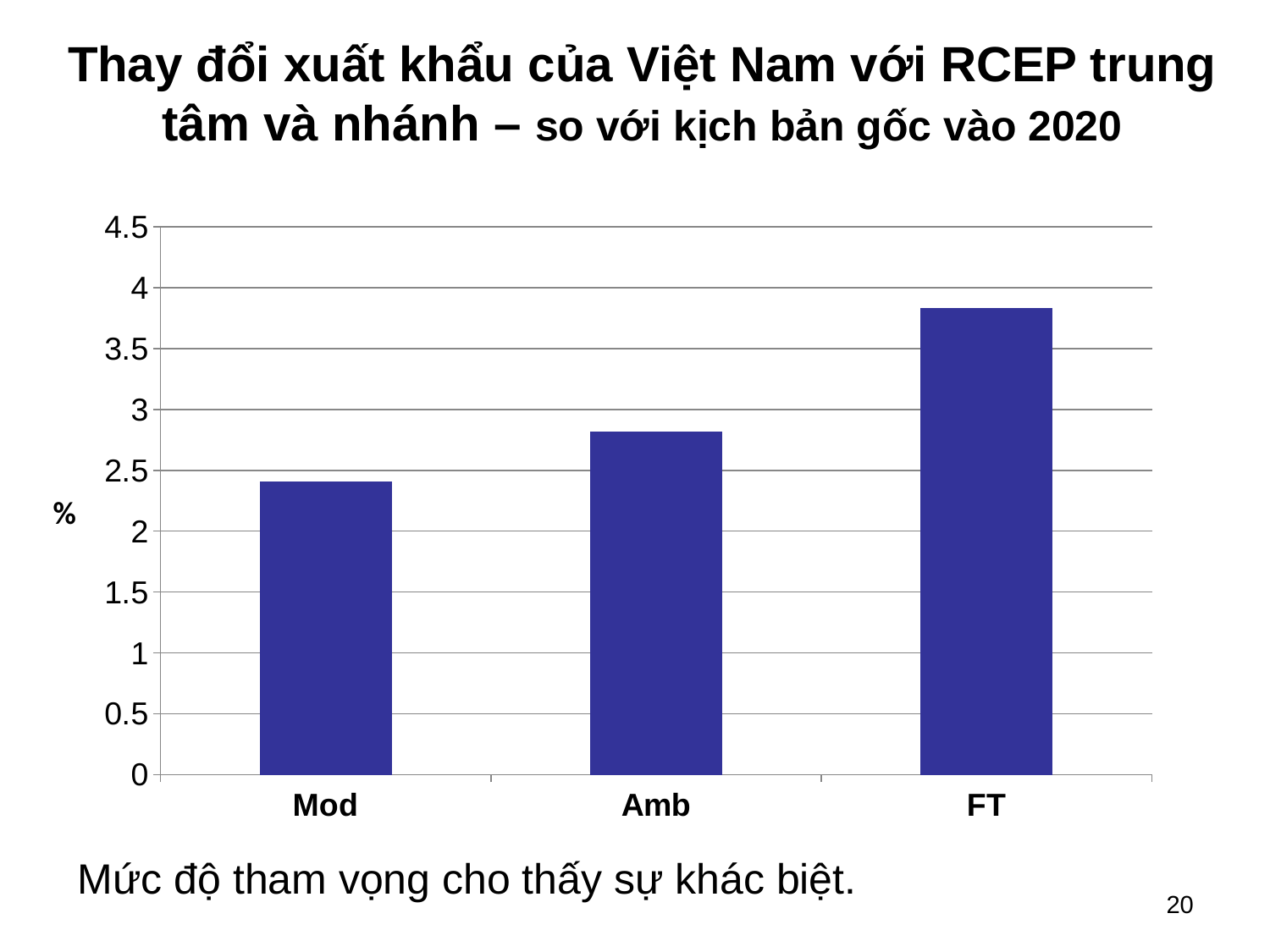
Is the value for FT greater or less than 4? less What kind of chart is shown on the slide? bar chart Which is larger, the value for FT or the value for Amb? FT Which is larger, the value for Amb or the value for Mod? Amb Is the value for Mod greater or less than 2? greater Is the value for FT greater or less than 3.5? greater Which category has the highest value? FT Which category has the lowest value? Mod How many categories are plotted on the x axis? 3 Do the values rise or fall from Mod to FT along the x axis? rise What is the label on the vertical axis? %